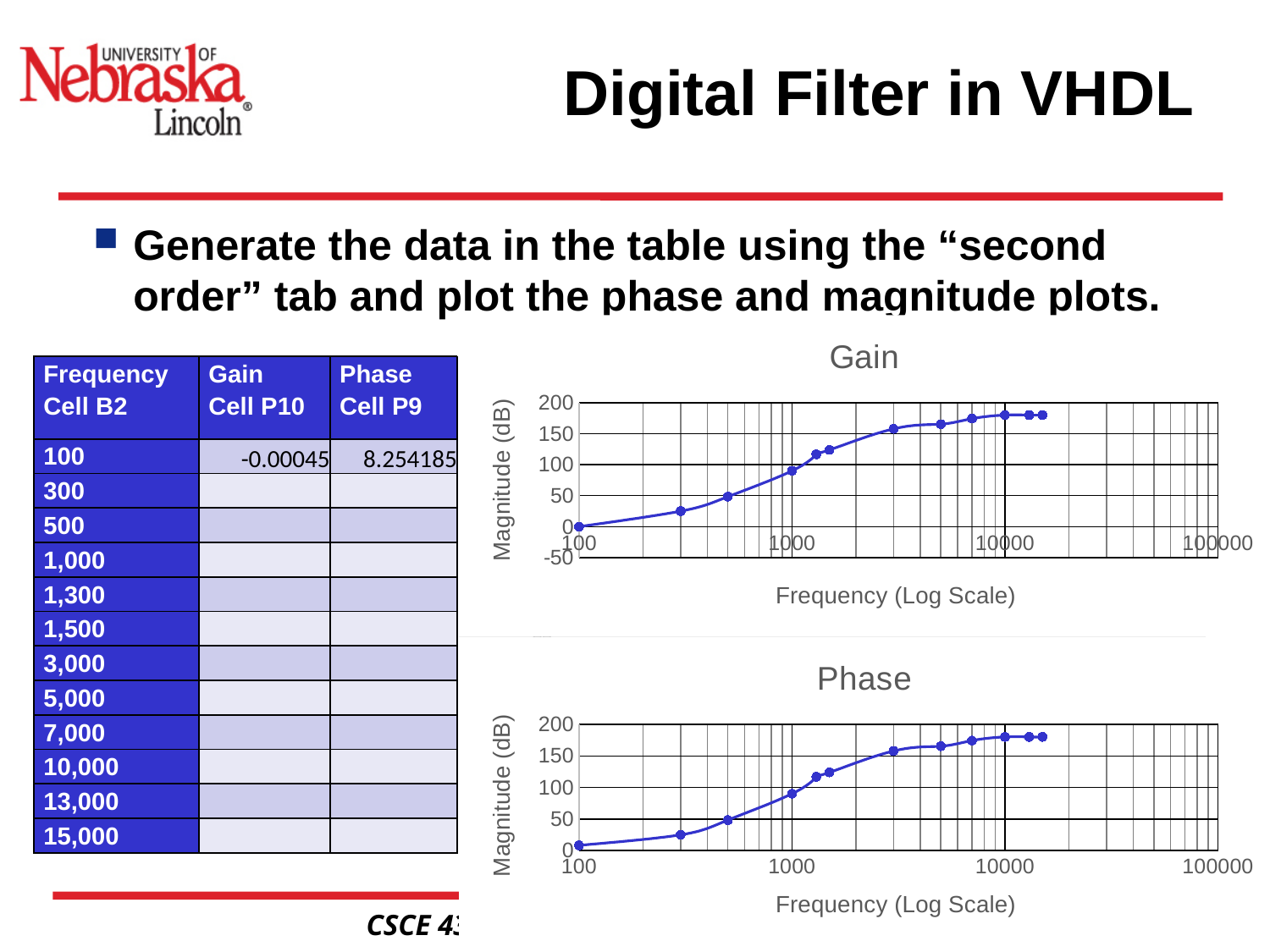
In the Gain chart, is the value at a frequency of 100 greater or less than 50? less In the Phase chart, is the value at a frequency of 1000 greater or less than 100? less What is the x-axis label of the Phase chart? Frequency (Log Scale) In the Gain chart, do the values rise or fall as frequency increases along the x axis? rise What type of chart is the Phase chart? line chart In the Phase chart, is the value at a frequency of 10000 greater or less than 150? greater What is the y-axis label of the Gain chart? Magnitude (dB) In the Phase chart, do the values rise or fall as frequency increases along the x axis? rise How many data points are plotted in the Gain chart? 12 What type of chart is the Gain chart? line chart